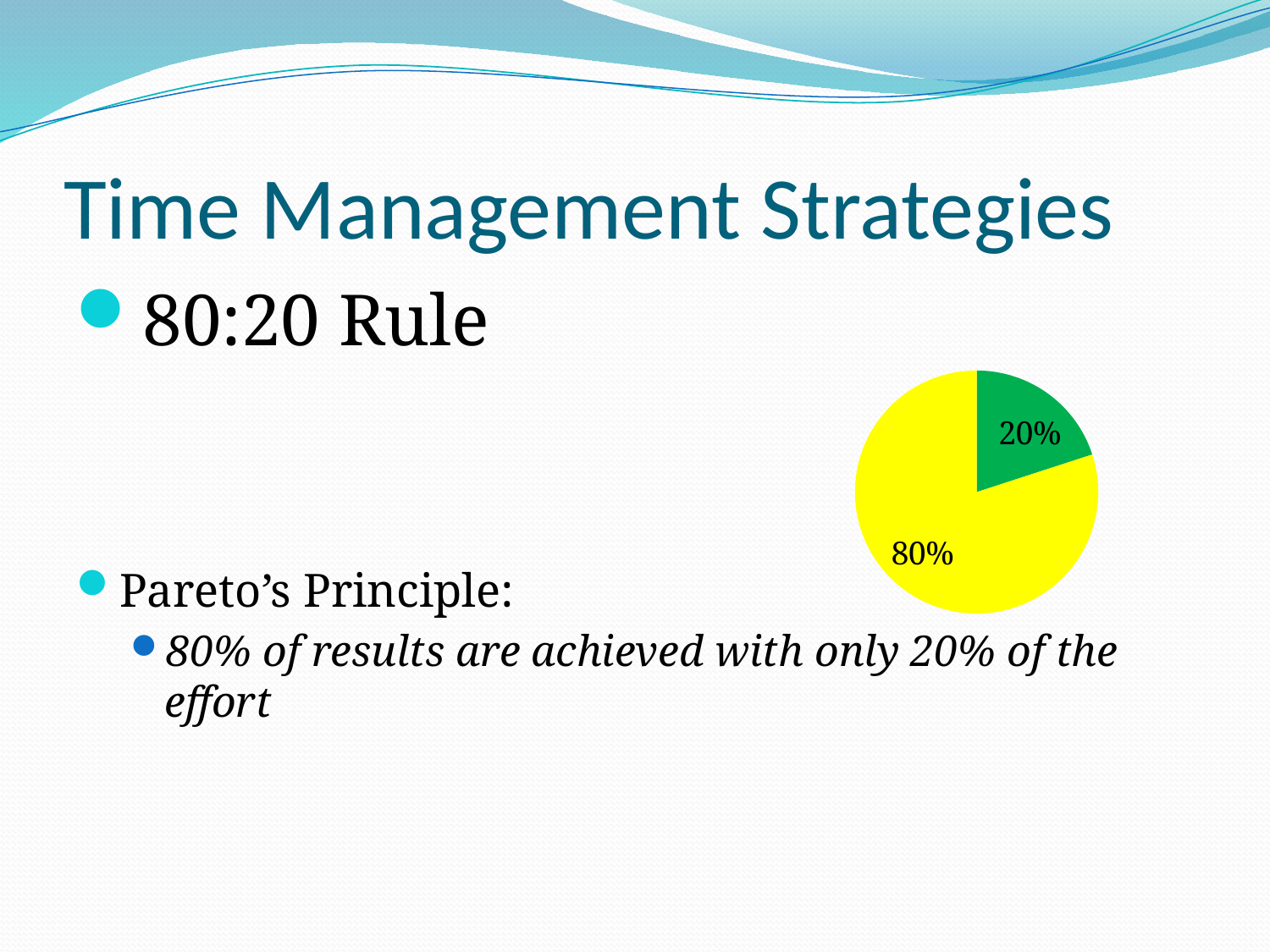
Which slice of the pie chart is the largest? the yellow slice (80%) What kind of chart is shown on the slide? pie chart Which is larger in the pie chart, the green slice or the yellow slice? the yellow slice What percentage is shown on the yellow slice of the pie chart? 80% What percentage is shown on the green slice of the pie chart? 20% How many slices does the pie chart have? 2 Which slice of the pie chart is the smallest? the green slice (20%) What colour is the 80% slice of the pie chart? yellow What share of the pie does the green slice represent? 20% Does the pie chart have a legend? no What is the difference between the two slice values in the pie chart? 60%